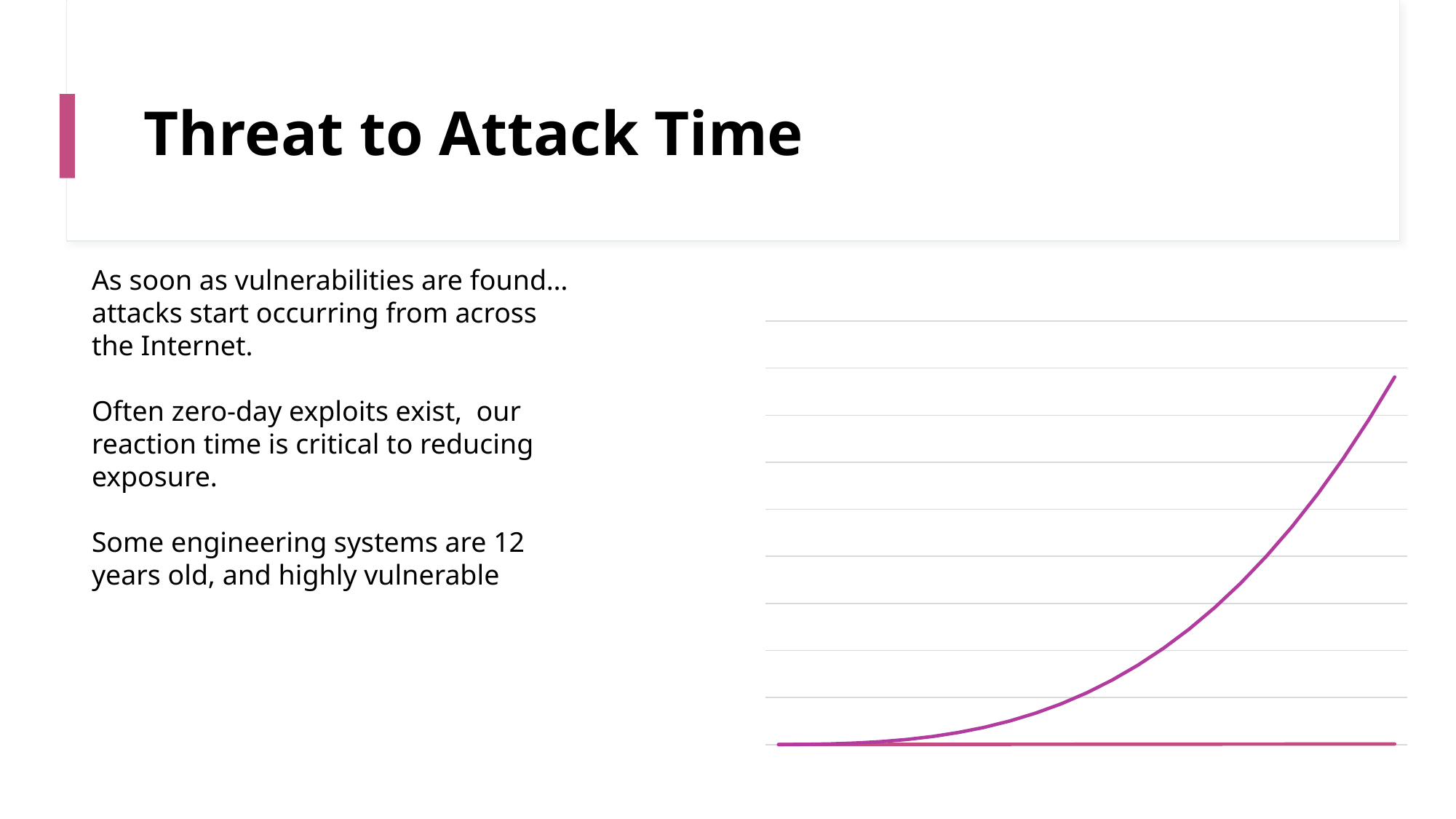
How many lines are plotted in the chart? 2 Does the curved line in the chart rise or fall from left to right? rise What colour are the lines in the chart? magenta What kind of chart is shown on the right side of the slide? line chart Does the chart have a legend? No